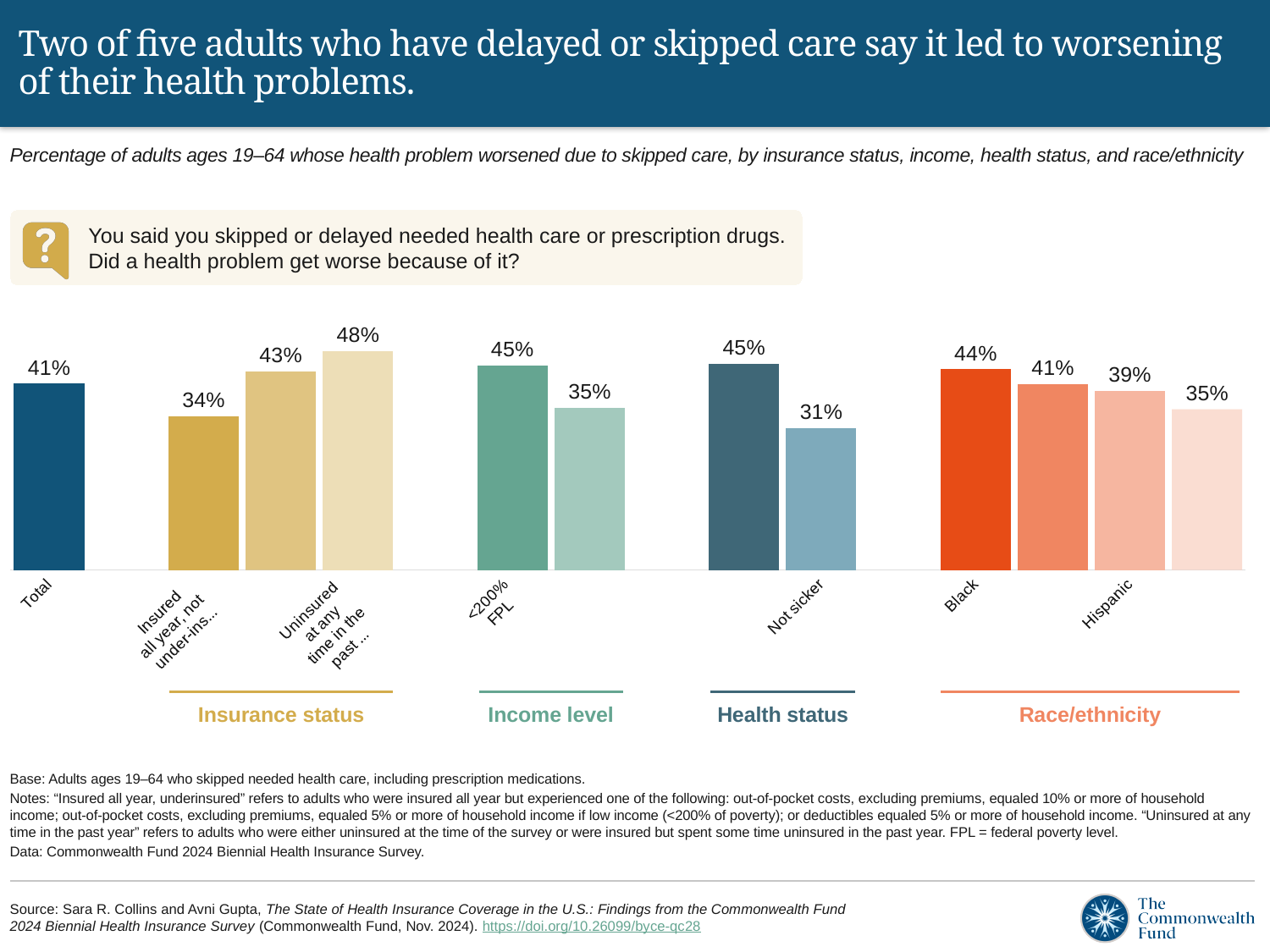
What is the value for Total? 41% Which bar has the highest value on the chart? Uninsured at any time in the past year (48%) What is the difference between the value for Black adults and the Total value? 3 percentage points What is the value for Black adults? 44% What is the value for the 'Not sicker' group? 31% What is the difference between the uninsured-at-any-time bar and the insured-all-year-not-underinsured bar? 14 percentage points What is the value for adults with income below 200% FPL? 45% Which bar has the lowest value on the chart? Not sicker (31%) What type of chart is shown on the slide? Bar chart What percentage is shown for adults uninsured at any time in the past year? 48% Which is larger: the value for adults below 200% FPL or the Total value? Adults below 200% FPL (45%) What is the value for adults insured all year, not underinsured? 34%